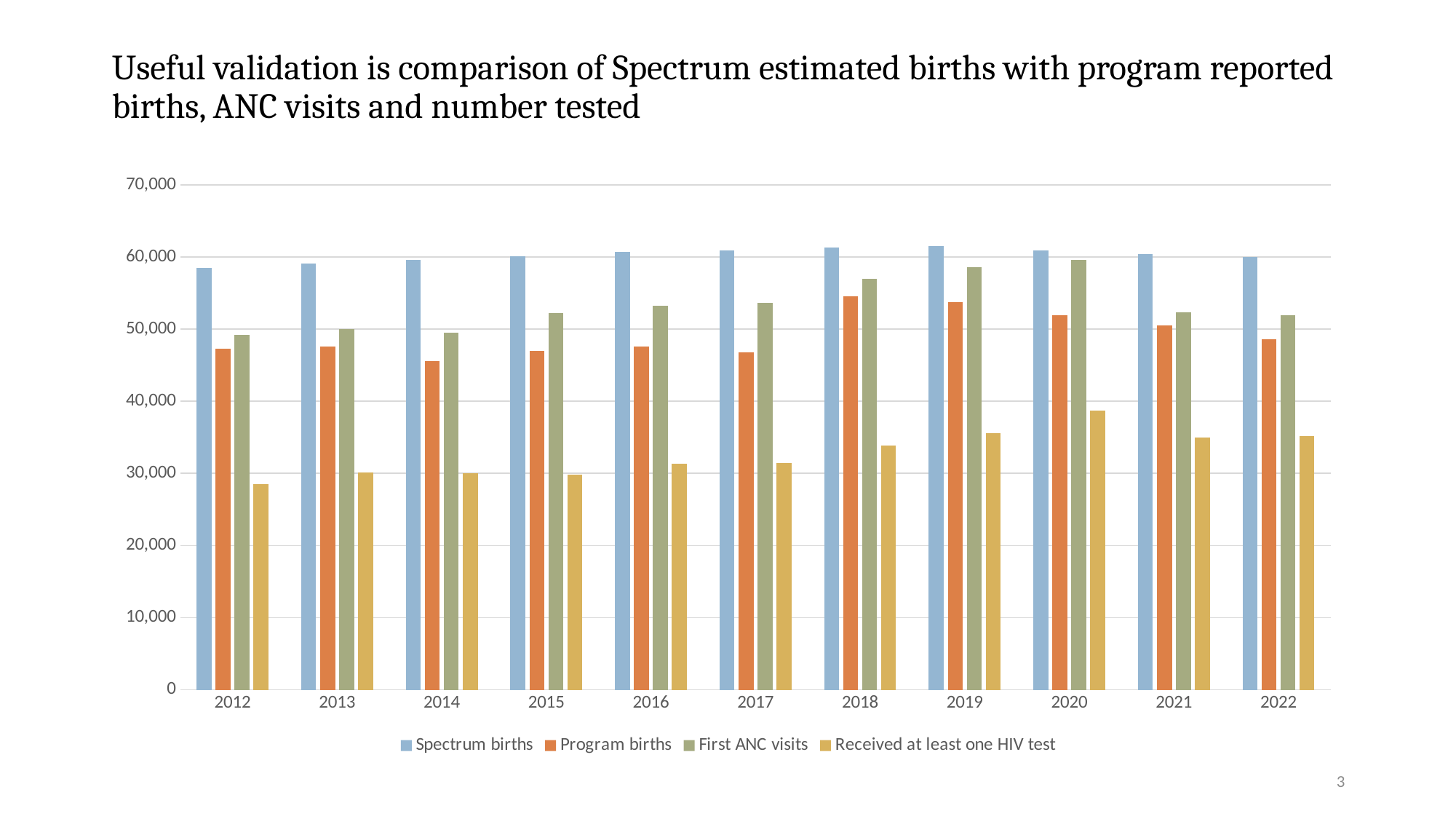
Is the value for Spectrum births in 2012 greater or less than 50,000? greater How many years are shown on the x axis? 11 In which year is the value for Program births highest? 2018 What kind of chart is shown on the slide? Bar chart Which series is shown in blue in the legend? Spectrum births In 2020, which is larger: First ANC visits or Program births? First ANC visits Is the value for Received at least one HIV test in 2020 greater or less than 40,000? less How many series does the legend list? 4 In which year is the value for Received at least one HIV test lowest? 2012 Is the value for Received at least one HIV test in 2012 greater or less than 30,000? less In 2022, which is larger: Program births or Received at least one HIV test? Program births In which year is the value for Received at least one HIV test highest? 2020